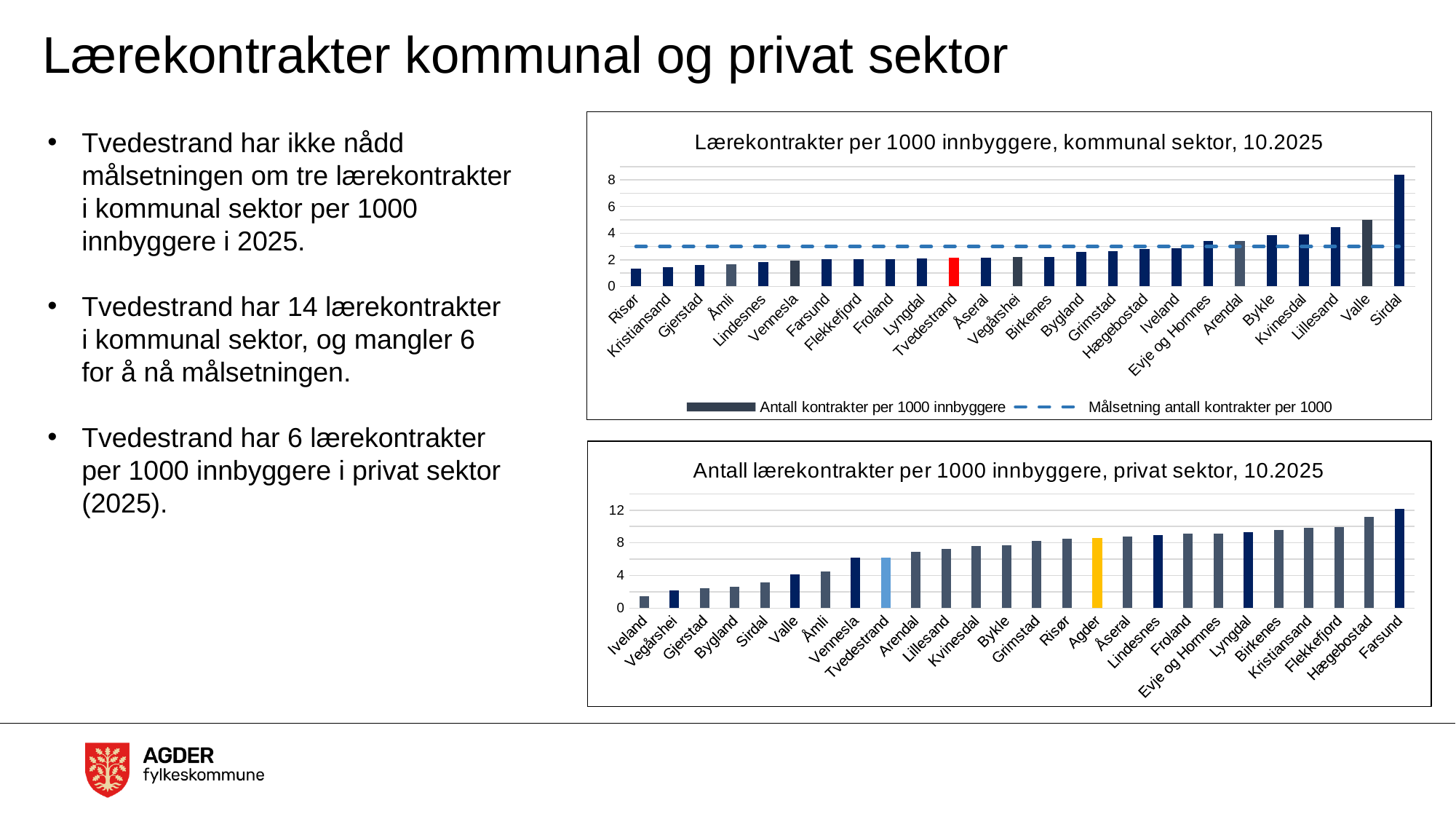
What type of chart is the top chart, 'Lærekontrakter per 1000 innbyggere, kommunal sektor, 10.2025'? Bar chart In the bottom chart (privat sektor), how many categories are shown on the x axis? 26 In the top chart (kommunal sektor), which is larger, the value for Valle or the value for Gjerstad? Valle In the top chart (kommunal sektor), what does the dashed line represent according to the legend? Målsetning antall kontrakter per 1000 In the top chart (kommunal sektor), is the value for Risør greater or less than 2? less In the bottom chart (privat sektor), which municipality has the highest value? Farsund In the top chart (kommunal sektor), is the value for Sirdal greater or less than 6? greater In the bottom chart (privat sektor), which municipality has the lowest value? Iveland In the top chart (kommunal sektor), how many entries does the legend list? 2 In the bottom chart (privat sektor), is the value for Farsund greater or less than 8? greater In the top chart (kommunal sektor), which municipality has the highest value? Sirdal In the bottom chart (privat sektor), do the values rise or fall from left to right along the x axis? Rise